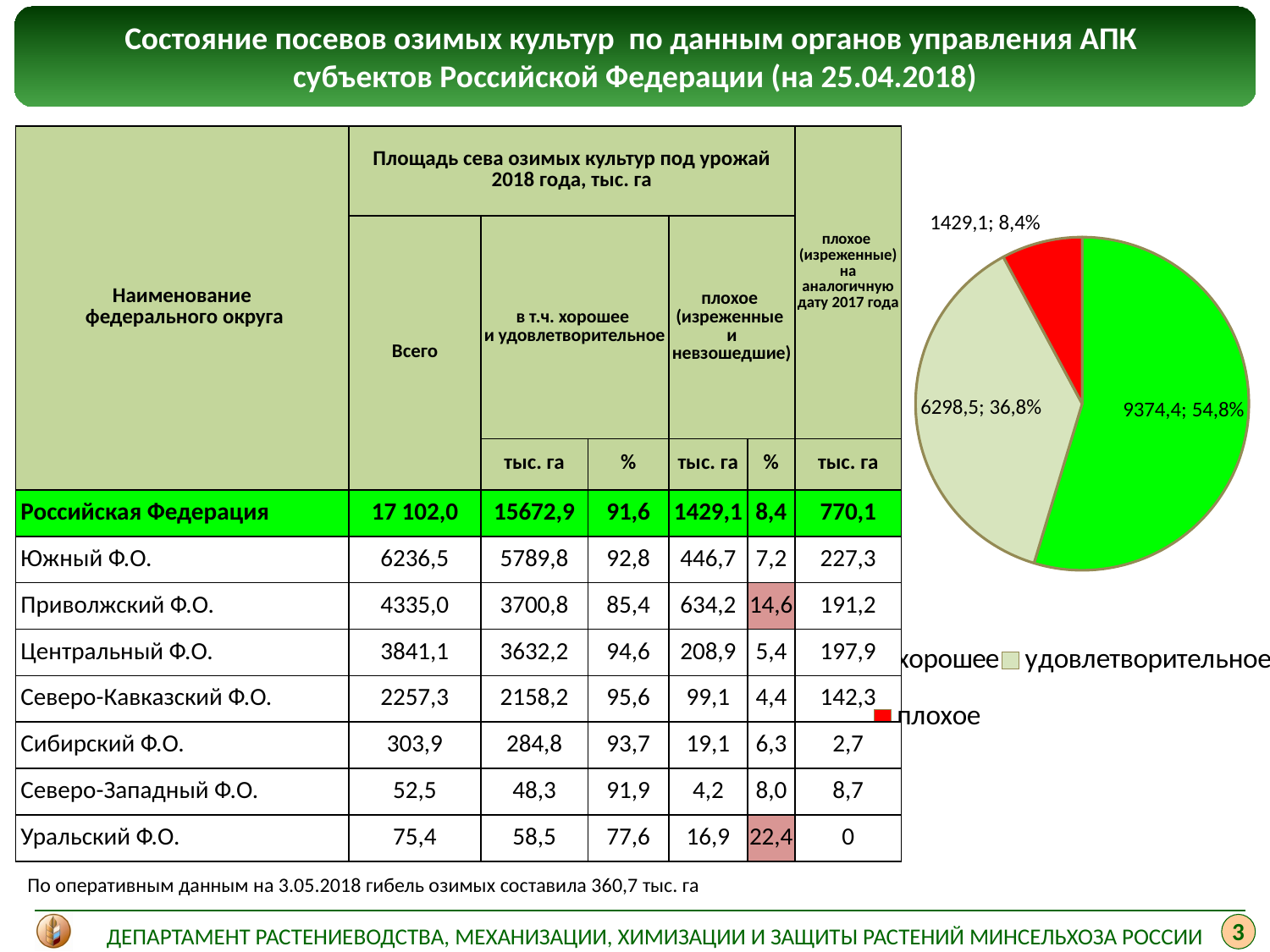
Which slice of the pie chart is the largest? хорошее What share of the pie chart does the 'плохое' slice represent? 8,4% In the pie chart, what is the difference between the 'хорошее' value and the 'удовлетворительное' value? 3075,9 How many entries does the pie chart legend list? 3 What share of the pie chart does the 'хорошее' slice represent? 54,8% What value is shown for the 'плохое' slice of the pie chart? 1429,1 How many slices does the pie chart have? 3 Which slice of the pie chart is the smallest? плохое What value is shown for the 'хорошее' slice of the pie chart? 9374,4 In the pie chart, which slice is larger: 'удовлетворительное' or 'плохое'? удовлетворительное What kind of chart is shown on the right side of the slide? pie chart What value is shown for the 'удовлетворительное' slice of the pie chart? 6298,5